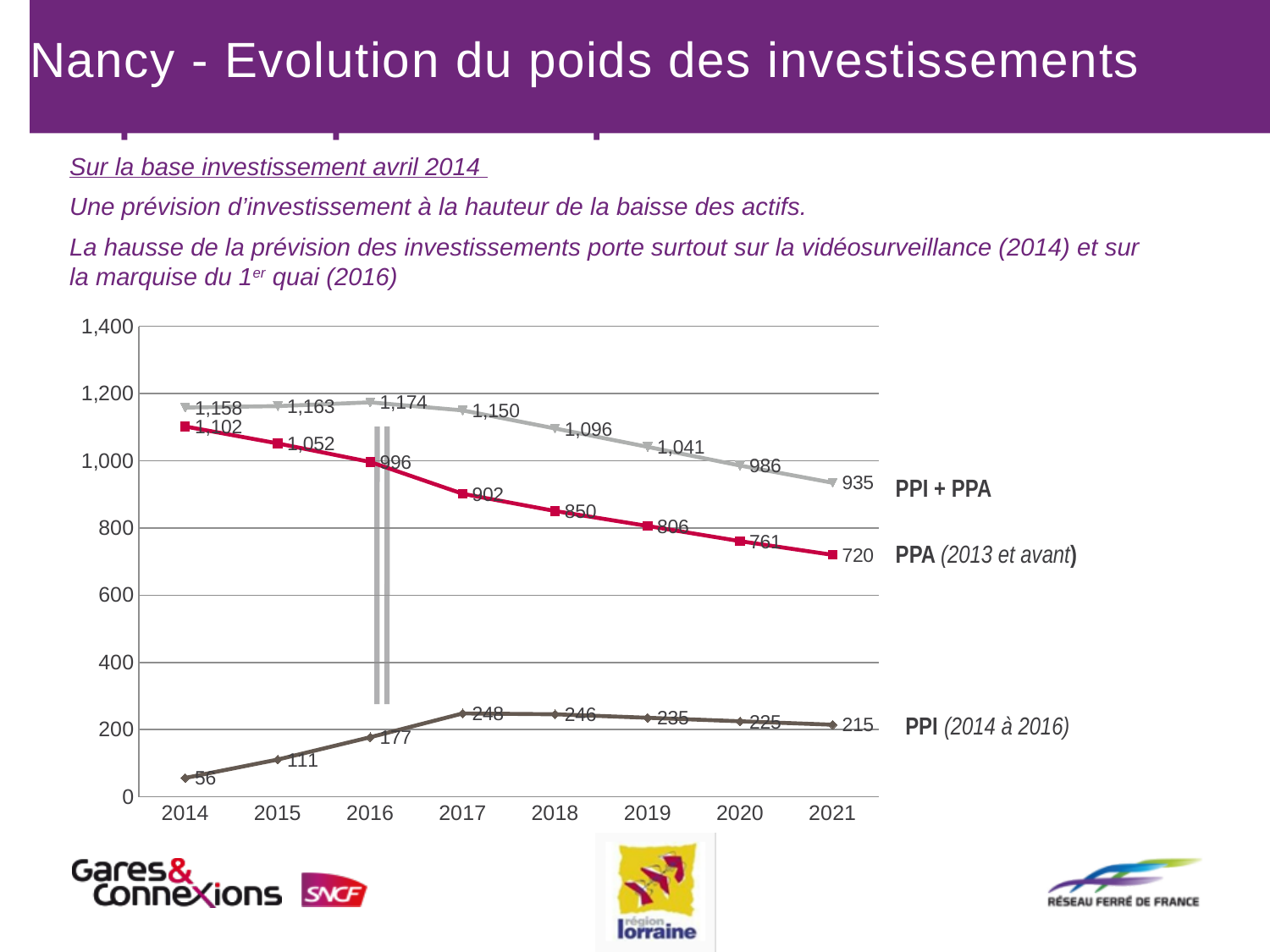
What is the value of the PPI (2014 à 2016) series in 2016? 177 What kind of chart is shown on the slide? Line chart How many series are plotted on the chart? 3 What is the value of the PPI + PPA series in 2021? 935 How many years are shown on the x axis of the chart? 8 By how much does the PPA (2013 et avant) series decrease from 2014 to 2021? 382 In which year is the PPI (2014 à 2016) series at its lowest? 2014 What is the difference between the PPI + PPA value and the PPA value in 2021? 215 In which year does the PPI + PPA series reach its highest value? 2016 What is the value of the PPA (2013 et avant) series in 2014? 1,102 Which year has the higher PPI (2014 à 2016) value, 2018 or 2019? 2018 What is the value of the PPI (2014 à 2016) series in 2017? 248